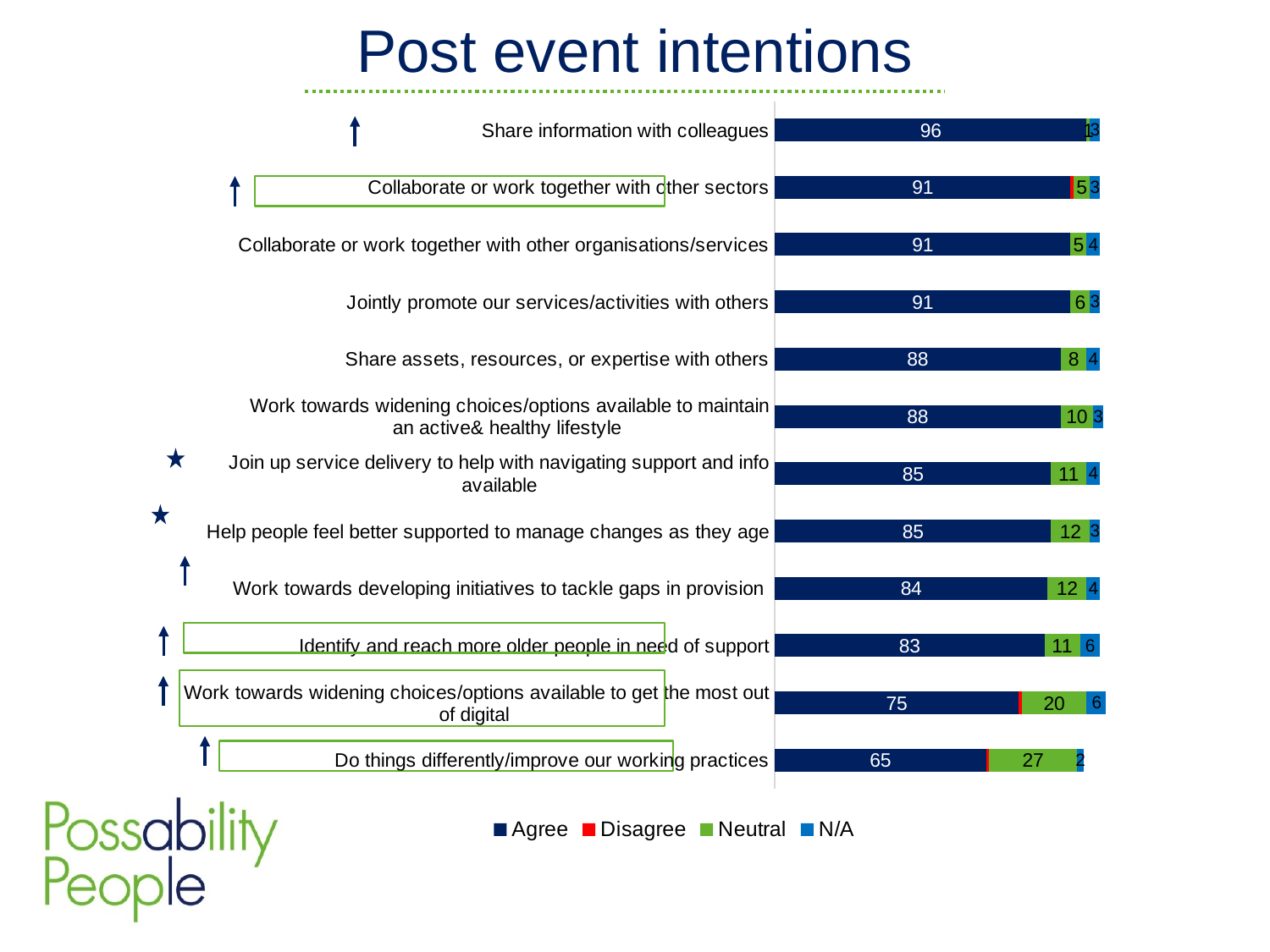
Which category has the highest Agree value? Share information with colleagues What kind of chart is shown on the slide? Bar chart What is the Neutral value for 'Do things differently/improve our working practices'? 27 How many categories (intentions) are plotted in the chart? 12 What is the Agree value for 'Do things differently/improve our working practices'? 65 What is the N/A value for 'Identify and reach more older people in need of support'? 6 What is the Neutral value for 'Work towards widening choices/options available to get the most out of digital'? 20 What is the Agree value for 'Share information with colleagues'? 96 Which has the larger Agree value: 'Share assets, resources, or expertise with others' or 'Work towards developing initiatives to tackle gaps in provision'? Share assets, resources, or expertise with others Which category has the lowest Agree value? Do things differently/improve our working practices How many series does the legend list? 4 What is the difference between the Agree values for 'Share information with colleagues' and 'Do things differently/improve our working practices'? 31